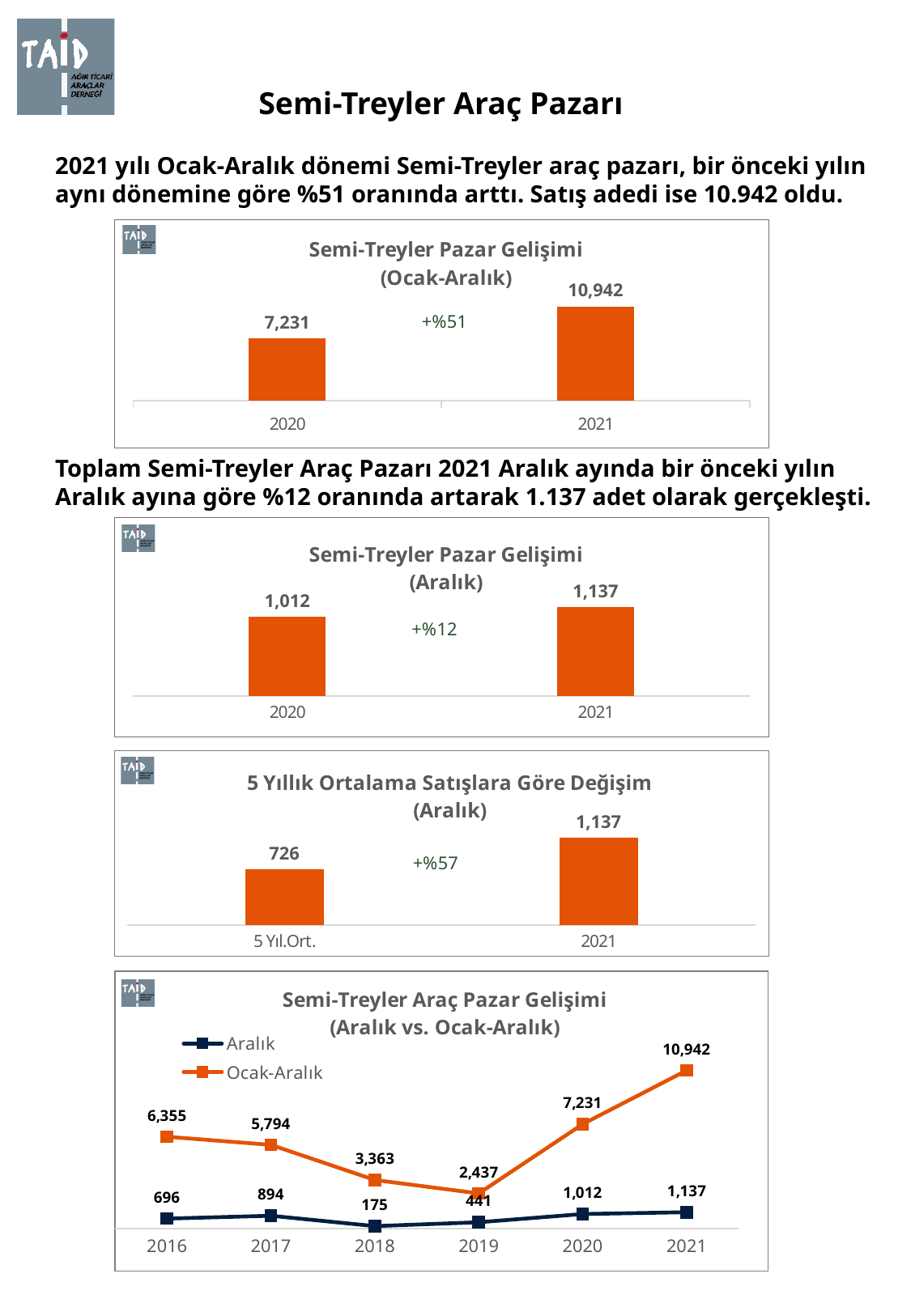
In the 'Semi-Treyler Pazar Gelişimi (Ocak-Aralık)' chart, what is the difference between the 2021 and 2020 values? 3,711 In the 'Semi-Treyler Araç Pazar Gelişimi (Aralık vs. Ocak-Aralık)' chart, how many years are shown on the x axis? 6 In the 'Semi-Treyler Araç Pazar Gelişimi (Aralık vs. Ocak-Aralık)' chart, which year has the lowest Ocak-Aralık value? 2019 In the 'Semi-Treyler Pazar Gelişimi (Aralık)' chart, what percentage change is shown between the two bars? +%12 In the 'Semi-Treyler Pazar Gelişimi (Aralık)' chart, what is the value for 2020? 1,012 In the 'Semi-Treyler Pazar Gelişimi (Ocak-Aralık)' chart, what is the value for 2021? 10,942 In the 'Semi-Treyler Araç Pazar Gelişimi (Aralık vs. Ocak-Aralık)' chart, does the Ocak-Aralık series rise or fall from 2019 to 2021? Rise How many series does the legend of the 'Semi-Treyler Araç Pazar Gelişimi (Aralık vs. Ocak-Aralık)' chart list? 2 In the '5 Yıllık Ortalama Satışlara Göre Değişim (Aralık)' chart, which category has the higher value? 2021 What kind of chart is the 'Semi-Treyler Araç Pazar Gelişimi (Aralık vs. Ocak-Aralık)' chart at the bottom of the slide? Line chart In the '5 Yıllık Ortalama Satışlara Göre Değişim (Aralık)' chart, what is the value for '5 Yıl.Ort.'? 726 In the 'Semi-Treyler Araç Pazar Gelişimi (Aralık vs. Ocak-Aralık)' chart, what is the Aralık value for 2018? 175